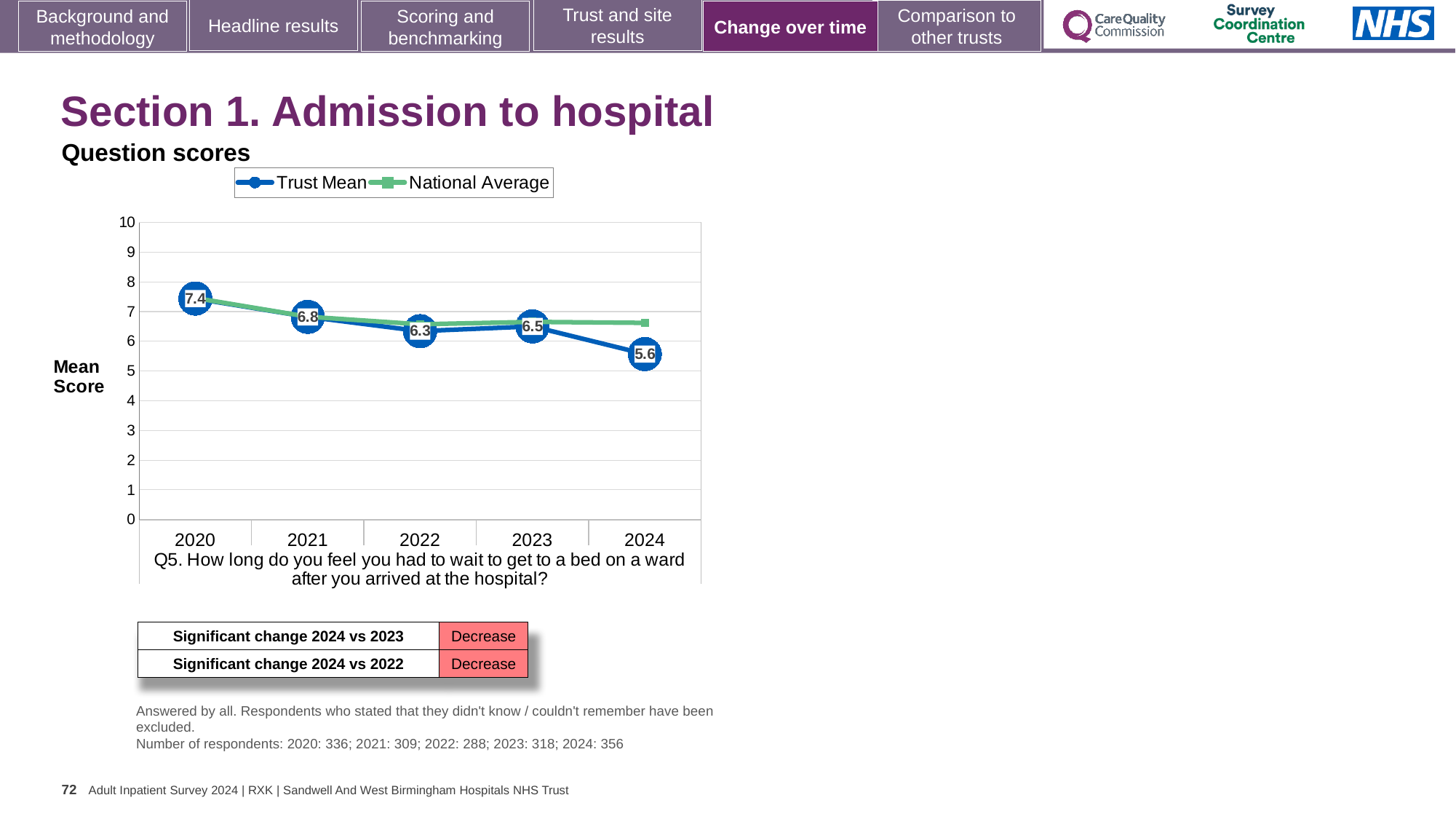
What is the Trust Mean score for 2024? 5.6 Is the National Average value for 2024 greater or less than 6? greater What kind of chart is shown on the slide? Line chart How many series does the chart legend list? 2 What is the difference between the Trust Mean scores for 2020 and 2024? 1.8 Which year has a higher Trust Mean score, 2021 or 2023? 2021 In which year is the Trust Mean score highest? 2020 In which year is the Trust Mean score lowest? 2024 What is the Trust Mean score for 2022? 6.3 Does the Trust Mean score rise or fall between 2023 and 2024? Fall How many years are shown on the x axis of the chart? 5 What is the Trust Mean score for 2020? 7.4